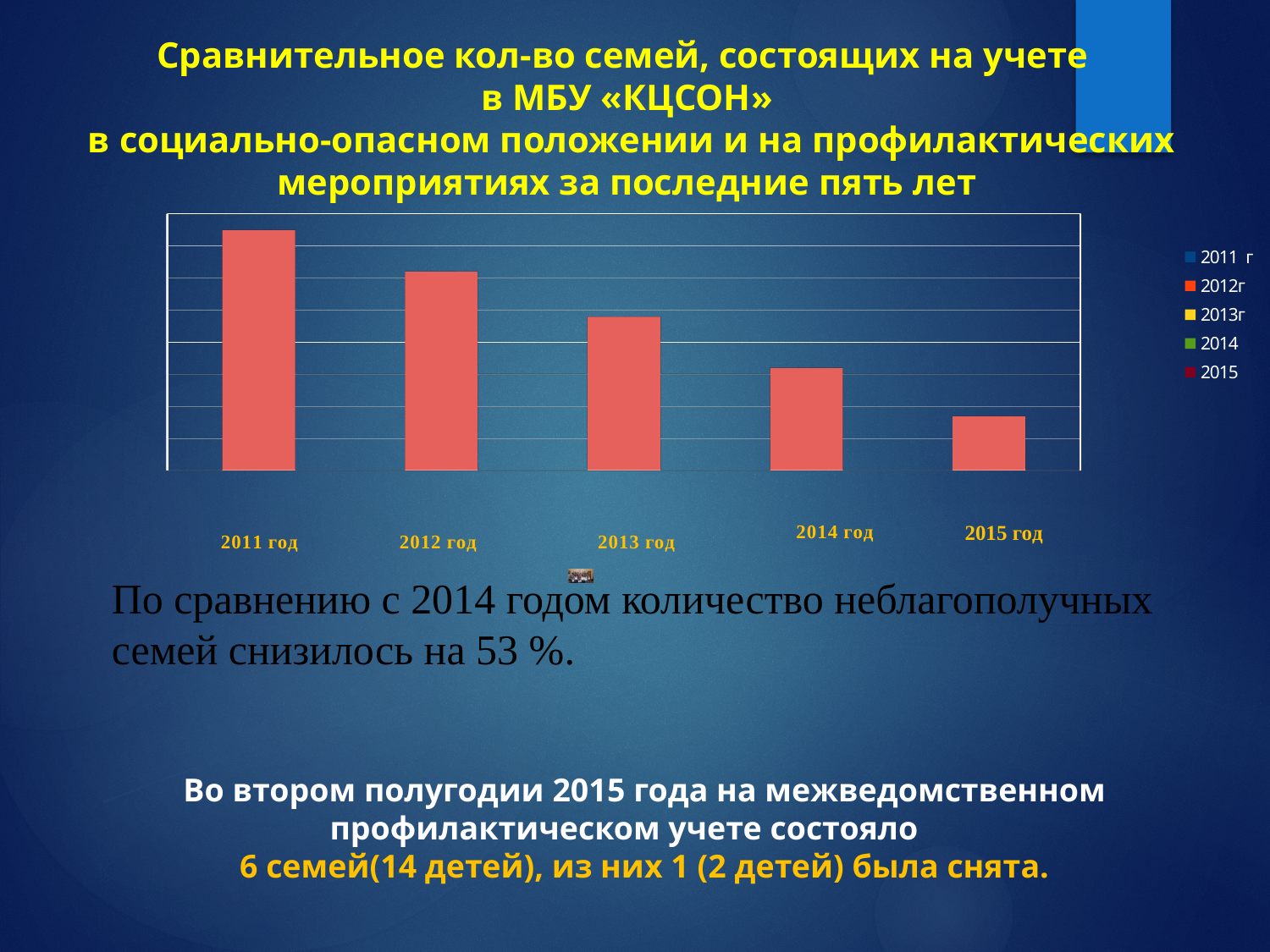
What colour are the bars in the chart? red Do the bar values rise or fall from 2011 год to 2015 год? fall What kind of chart is shown on the slide? bar chart Which year has the shortest bar in the chart? 2015 год How many entries does the chart legend list? 5 Which bar is taller, 2013 год or 2015 год? 2013 год Which year has the tallest bar in the chart? 2011 год What is the first category label on the x axis of the chart? 2011 год How many bars (years) are plotted in the chart? 5 Which bar is taller, 2012 год or 2014 год? 2012 год